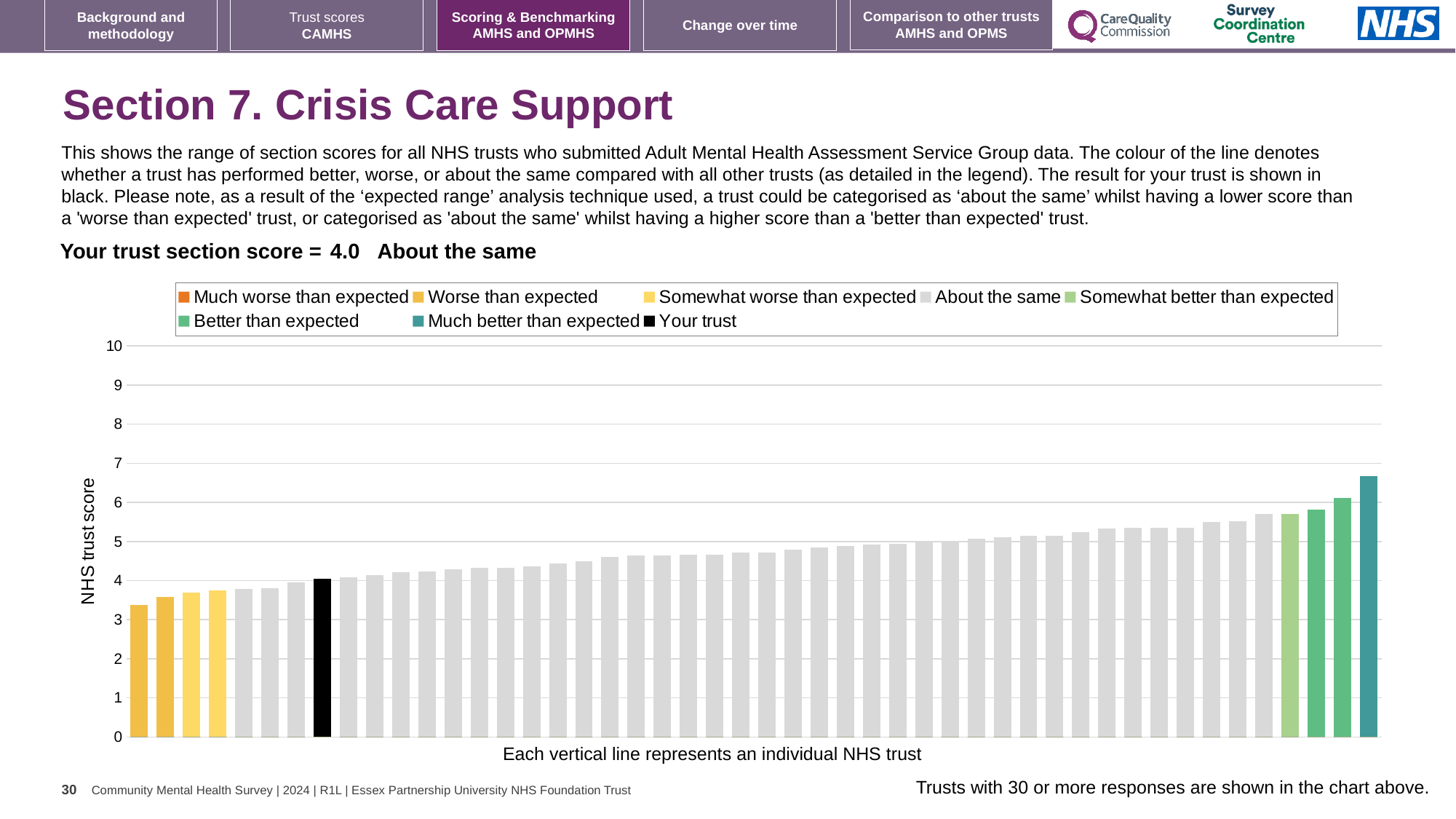
What kind of chart is shown on the slide? bar chart What is the label on the vertical axis of the chart? NHS trust score Which legend category does the tallest bar belong to? Much better than expected Is the value of the tallest bar greater or less than 6? greater Which category is your trust's section score placed in? About the same What is the section score for your trust shown on the slide? 4.0 Is the value of the shortest bar greater or less than 4? less How many entries does the chart legend list? 8 Do the bar values rise or fall from left to right across the chart? rise How many bars are coloured as 'Much better than expected'? 1 Is the value of the tallest bar greater or less than 7? less